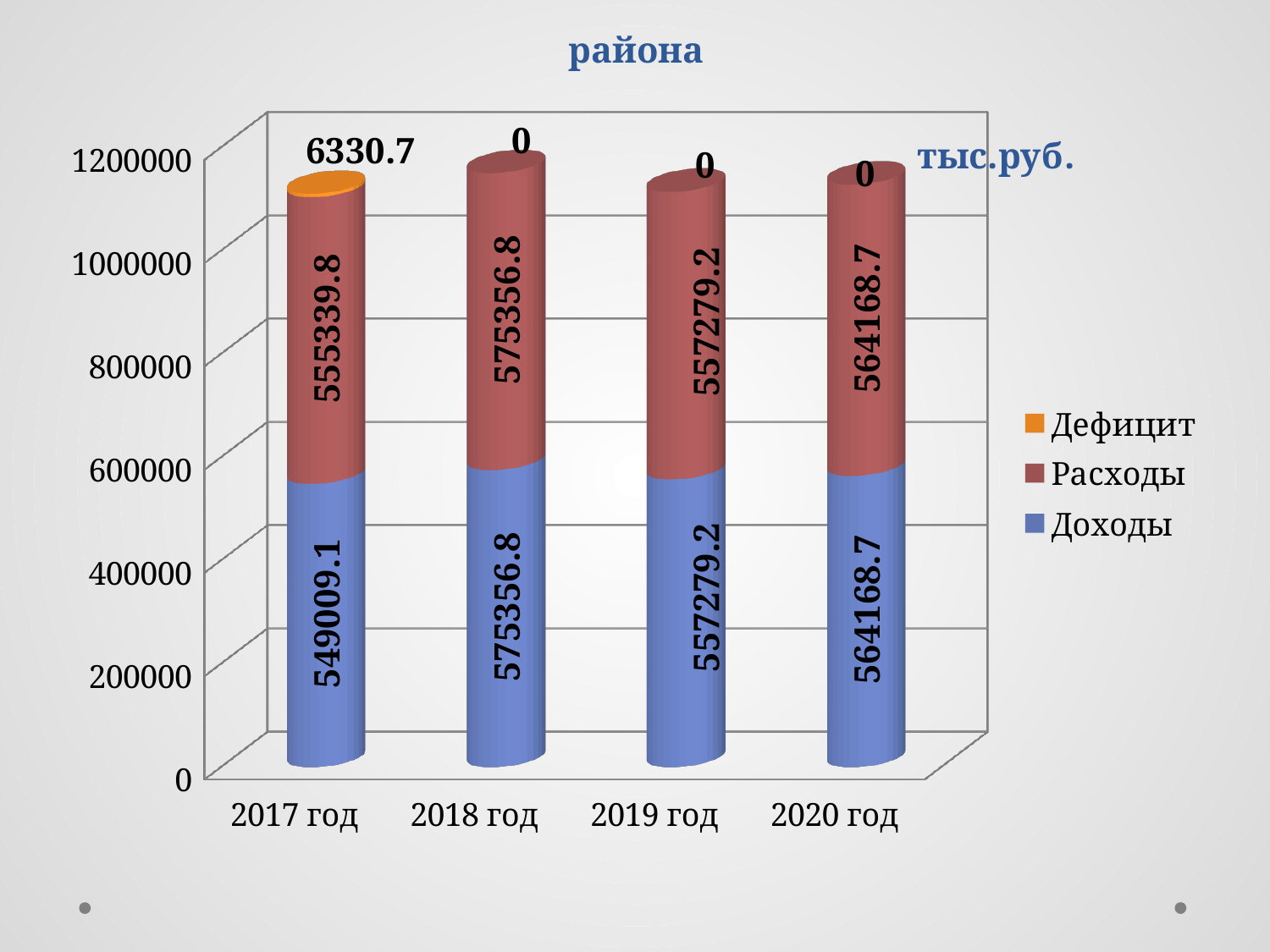
What kind of chart is shown on the slide? Stacked bar chart How many years are shown on the x axis? 4 What is the value of Дефицит for 2017 год? 6330.7 What is the total of the stacked bar for 2018 год? 1150713.6 Which year has the highest value for Доходы? 2018 год What is the value of Доходы for 2017 год? 549009.1 What is the value of Расходы for 2018 год? 575356.8 Which year has the lowest value for Доходы? 2017 год Which is larger: Расходы in 2020 год or Расходы in 2019 год? 2020 год How many series does the legend list? 3 What is the difference between Расходы and Доходы in 2017 год? 6330.7 What is the value of Дефицит for 2019 год? 0